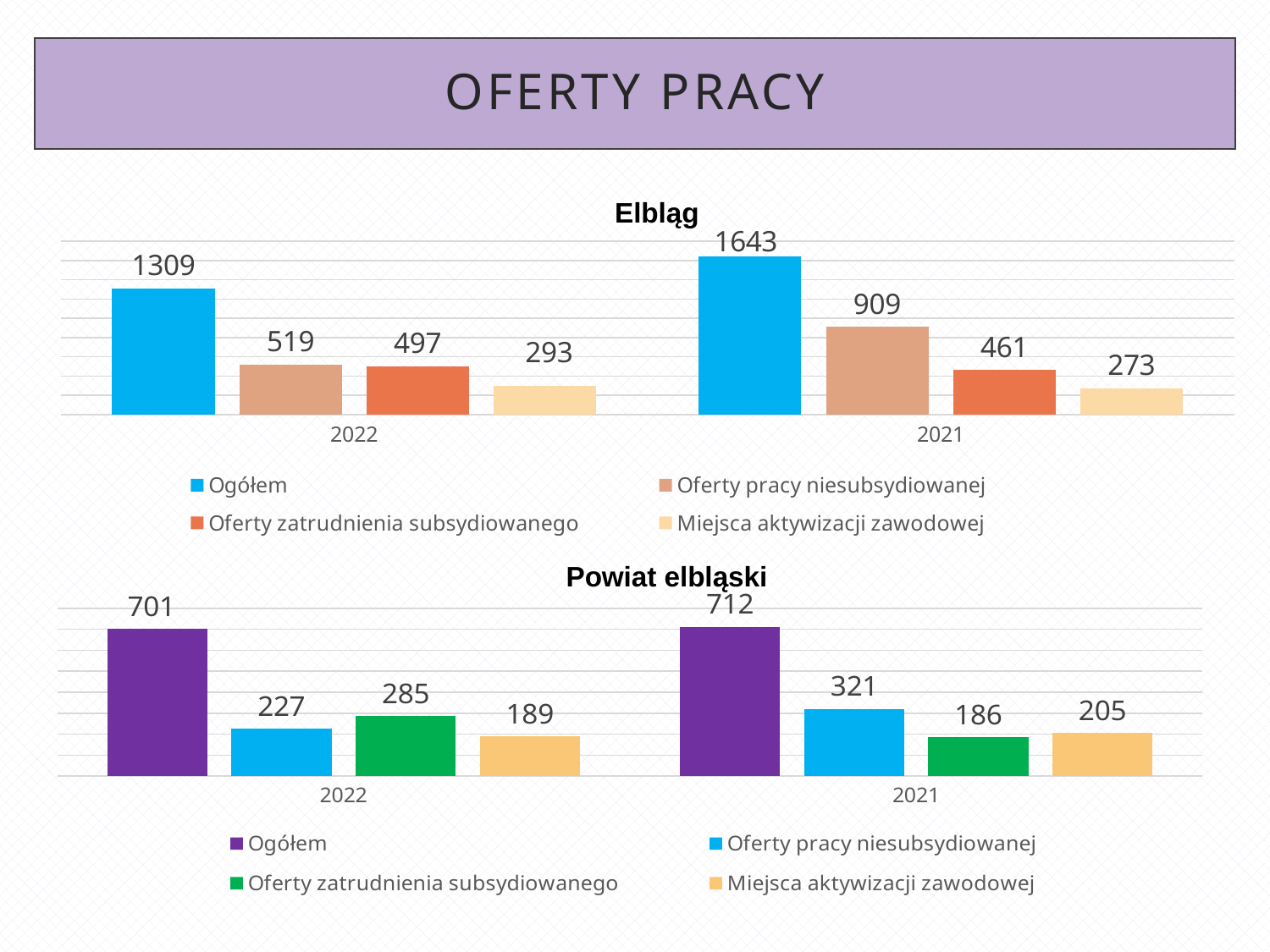
In the Powiat elbląski chart, which series has the highest value in 2022? Ogółem In the Powiat elbląski chart, what is the value of Oferty zatrudnienia subsydiowanego for 2021? 186 In the Elbląg chart, what is the value of Ogółem for 2022? 1309 In the Powiat elbląski chart, what is the value of Miejsca aktywizacji zawodowej for 2022? 189 How many series does the legend of the Powiat elbląski chart list? 4 In the Elbląg chart, what is the value of Oferty pracy niesubsydiowanej for 2021? 909 In the Powiat elbląski chart, what is the difference between Oferty pracy niesubsydiowanej in 2021 and in 2022? 94 In the Elbląg chart, what is the difference between Ogółem in 2021 and Ogółem in 2022? 334 In the Elbląg chart, which series has the lowest value in 2021? Miejsca aktywizacji zawodowej What type of chart is the Elbląg chart? Bar chart In the Powiat elbląski chart, what colour are the Ogółem bars? Purple In the Elbląg chart, is Oferty zatrudnienia subsydiowanego larger in 2022 or in 2021? 2022